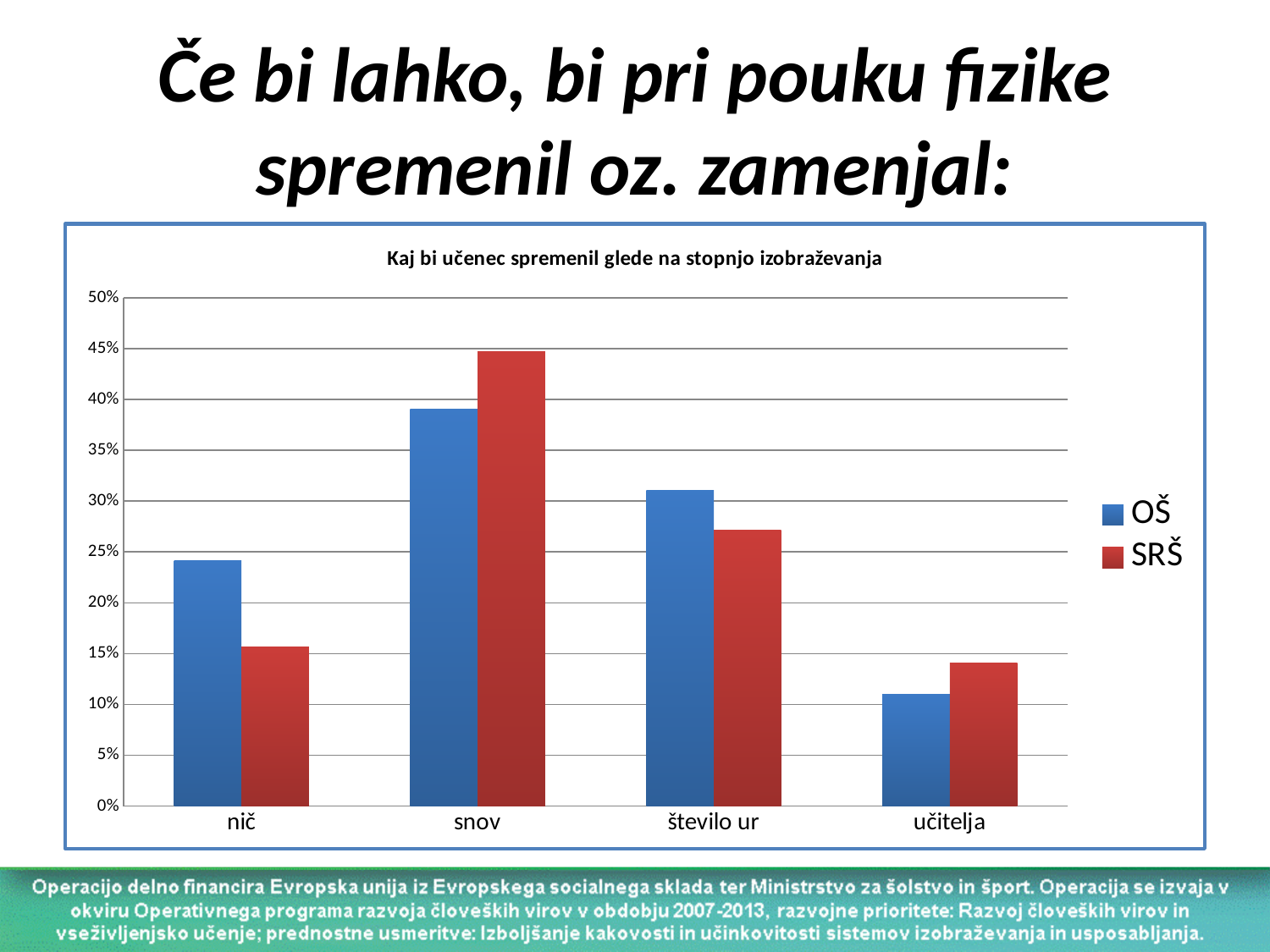
Which category has the lowest value for the OŠ series? učitelja For the category 'nič', which series has the larger value, OŠ or SRŠ? OŠ Which category has the highest value for the OŠ series? snov Which category has the highest value for the SRŠ series? snov How many categories are shown on the x axis? 4 Is the value for OŠ in the category 'nič' greater or less than 20%? greater What kind of chart is shown on the slide? bar chart Is the value for SRŠ in the category 'snov' greater or less than 40%? greater For the category 'snov', which series has the larger value, OŠ or SRŠ? SRŠ How many series does the legend list? 2 What is the title of the chart? Kaj bi učenec spremenil glede na stopnjo izobraževanja